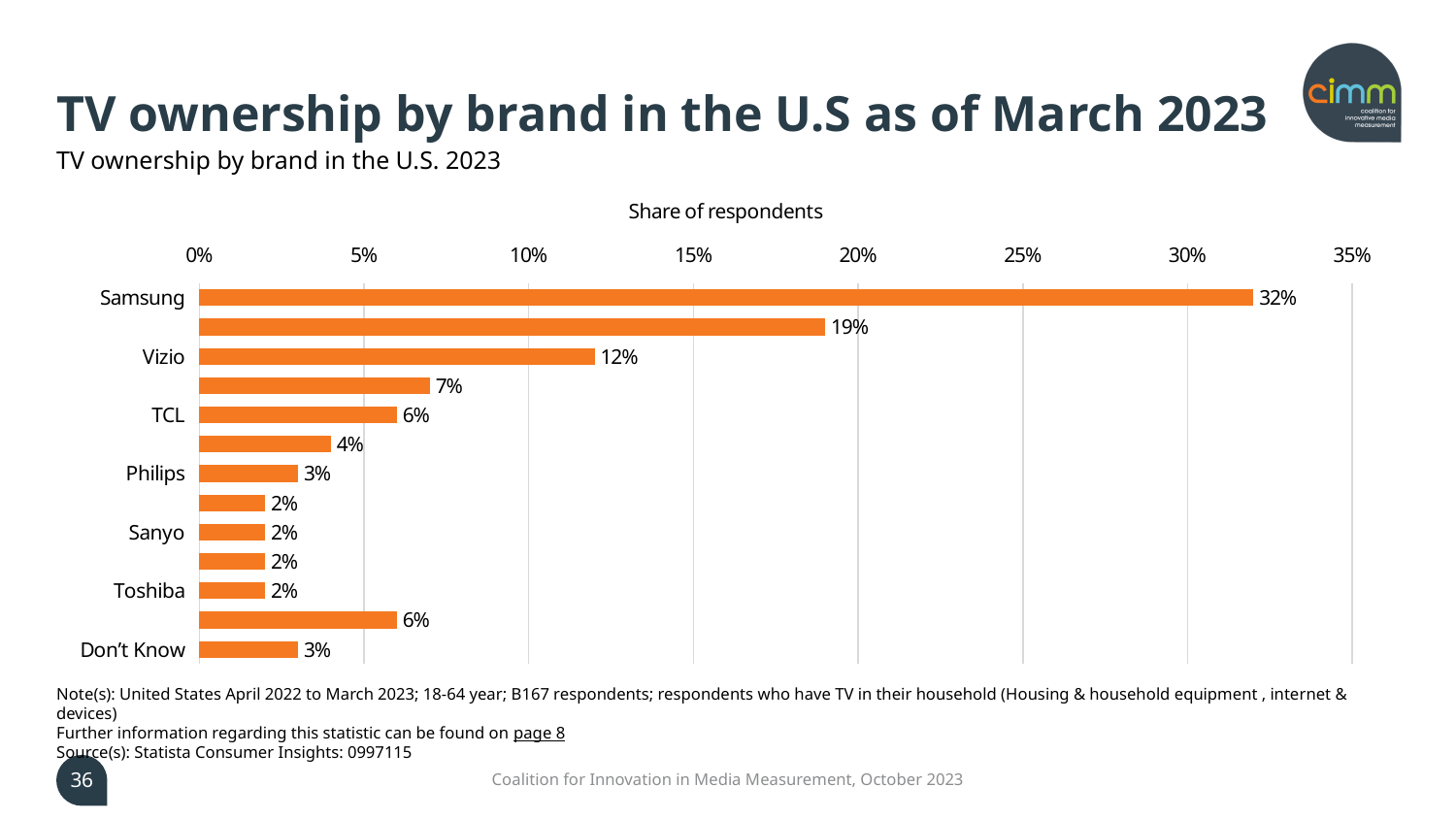
What is the title shown above the chart's axis? Share of respondents Which brand has the highest share of respondents? Samsung What share of respondents own a Samsung TV? 32% What share of respondents answered 'Don't Know'? 3% What value is shown for Philips? 3% Which has a larger share of respondents, Vizio or TCL? Vizio Is the value for Samsung greater or less than 30%? greater What is the difference in percentage points between Samsung and Vizio? 20 percentage points How many bars are plotted in the chart? 13 What share of respondents is shown for TCL? 6% What type of chart is shown on the slide? Bar chart What is the value shown for Vizio? 12%